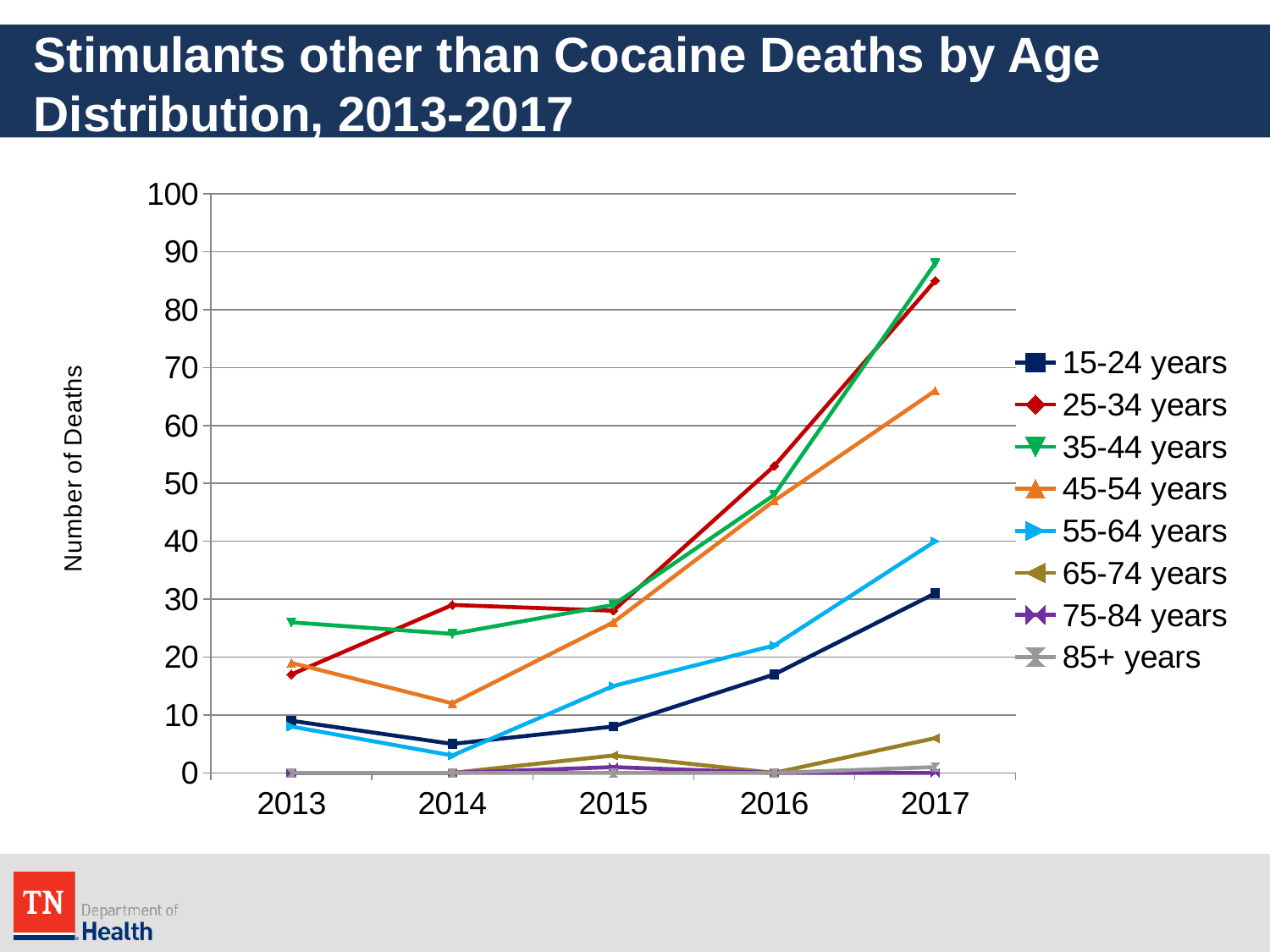
Is the value for 45-54 years in 2014 greater or less than 20? less Is the value for 45-54 years in 2017 greater or less than 60? greater Does the value for 45-54 years rise or fall from 2014 to 2017? rise Is the value for 55-64 years in 2014 greater or less than 10? less In 2017, which is larger: the value for 45-54 years or the value for 55-64 years? 45-54 years How many years are plotted along the x axis? 5 How many series does the legend list? 8 What kind of chart is shown on the slide? line chart In which year was the number of deaths for 15-24 years lowest? 2014 What is the title of the y axis? Number of Deaths Which age group had the highest number of deaths in 2013? 35-44 years